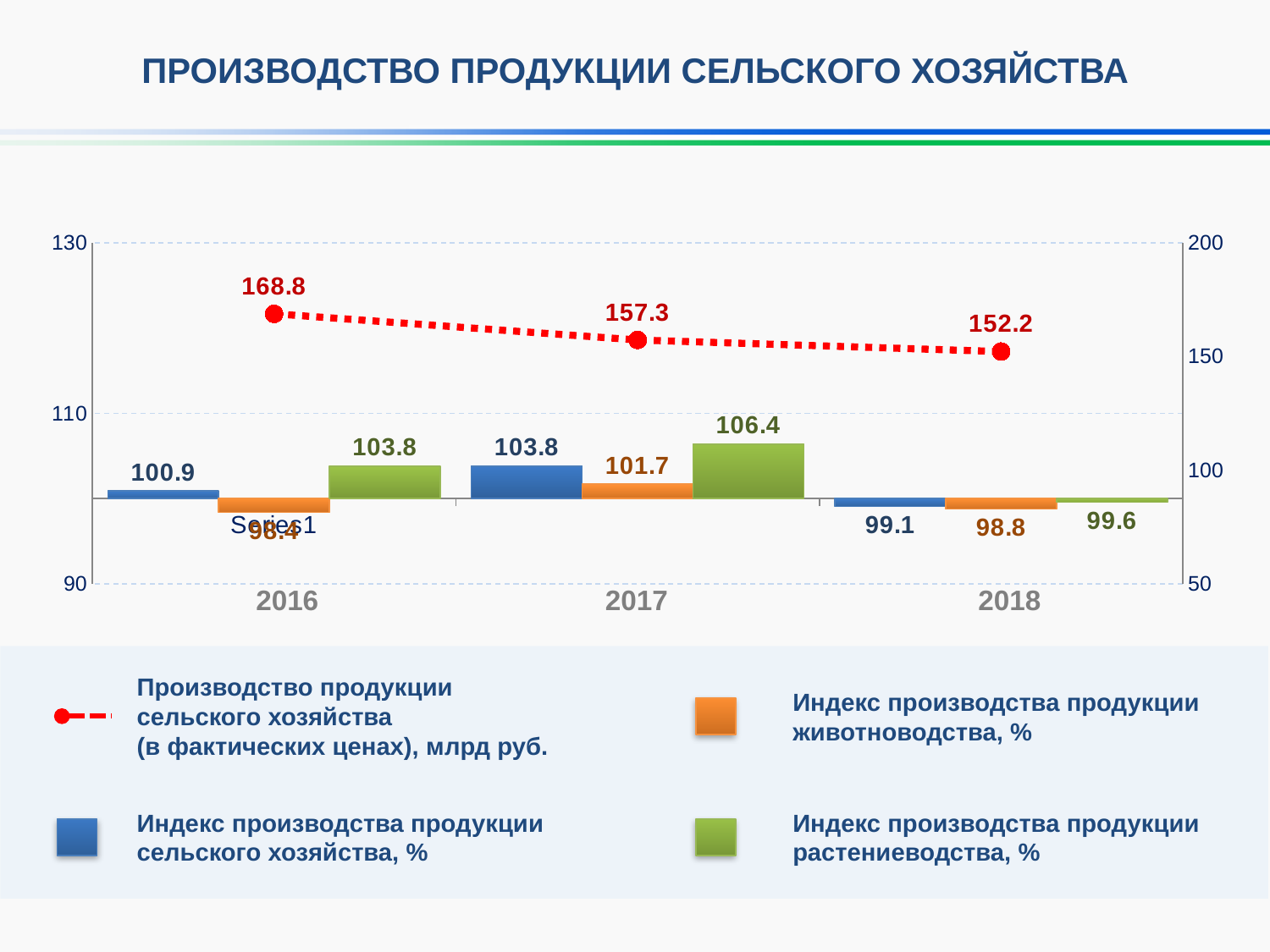
What is the Индекс производства продукции сельского хозяйства, % (blue bar) for 2018? 99.1 How many years are shown on the x axis? 3 What is the Индекс производства продукции растениеводства, % (green bar) for 2017? 106.4 Which is larger in 2017: the blue bar (Индекс производства продукции сельского хозяйства, %) or the orange bar (Индекс производства продукции животноводства, %)? Blue bar (103.8) In which year is the red dotted line (Производство продукции сельского хозяйства, млрд руб.) lowest? 2018 What is the difference between the red dotted line values for 2016 and 2017? 11.5 In which year is the Индекс производства продукции растениеводства, % (green bar) highest? 2017 What is the value of the red dotted line (Производство продукции сельского хозяйства, млрд руб.) for 2016? 168.8 What is the Индекс производства продукции животноводства, % (orange bar) for 2016? 98.4 How many series does the legend list? 4 What is the value of the red dotted line (Производство продукции сельского хозяйства, млрд руб.) for 2018? 152.2 Does the red dotted line rise or fall from 2016 to 2018? Fall